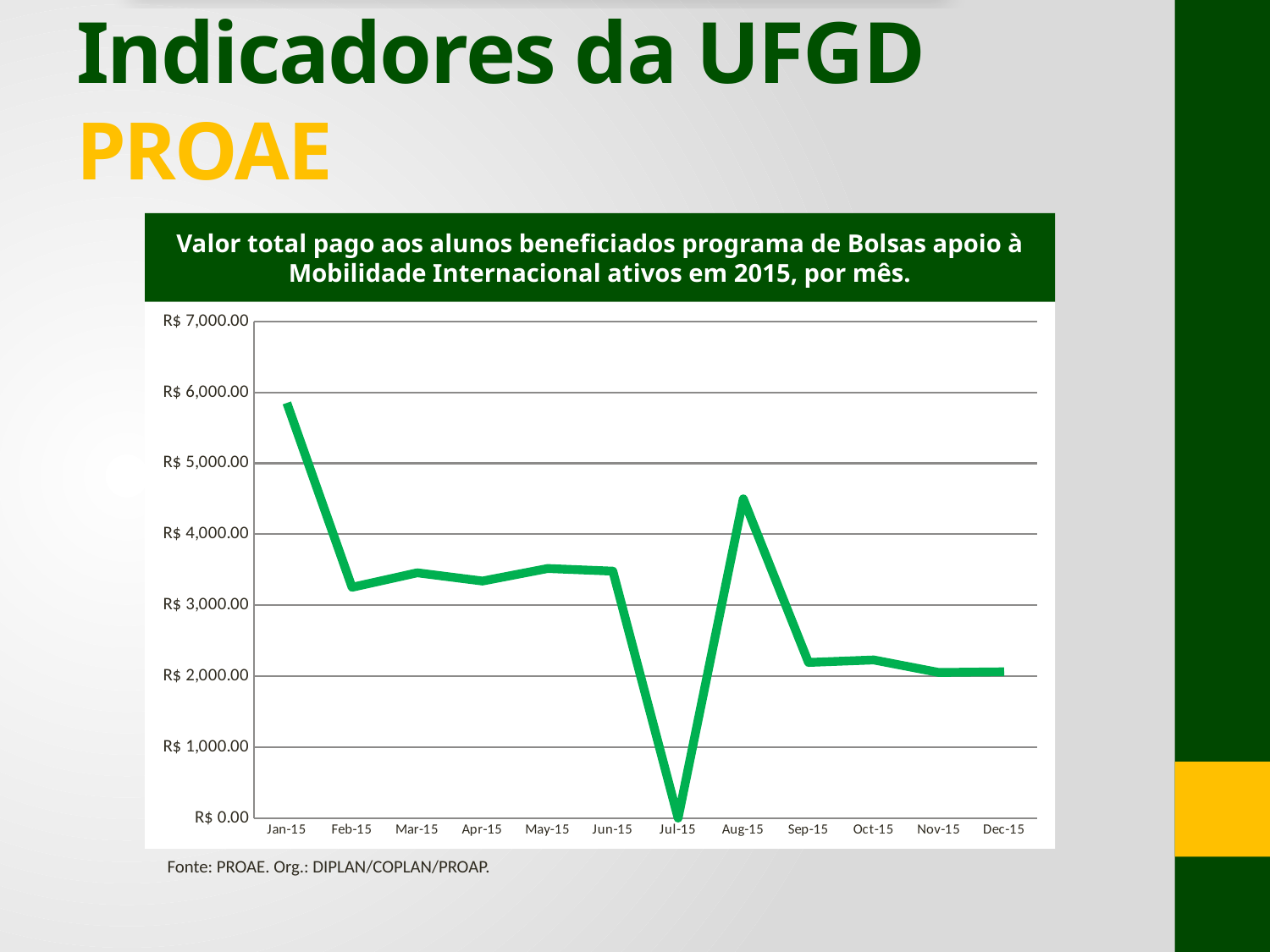
What kind of chart is shown on the slide? line chart Which month has the highest value in the chart? Jan-15 Which is larger, the value for Jan-15 or the value for Aug-15? Jan-15 How many months are plotted on the x axis of the chart? 12 What is the value for Jul-15? R$ 0.00 Which month has the lowest value in the chart? Jul-15 What colour is the line in the chart? green Is the value for Dec-15 greater or less than R$ 3,000.00? less Is the value for Jan-15 greater or less than R$ 5,000.00? greater Is the value for Aug-15 greater or less than R$ 4,000.00? greater Does the value rise or fall from Jan-15 to Feb-15? fall Which is larger, the value for Aug-15 or the value for Sep-15? Aug-15